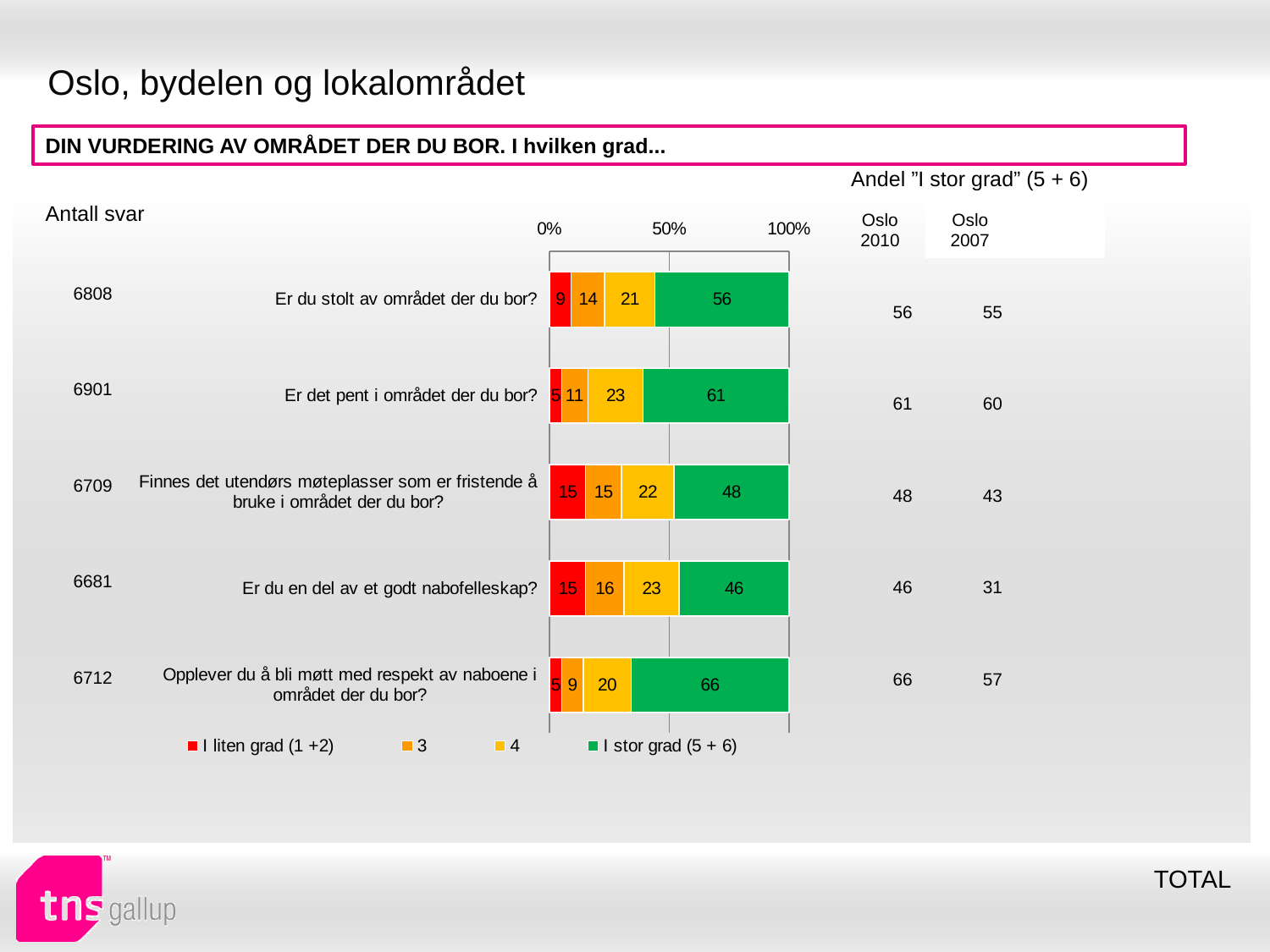
What kind of chart is shown on the slide? Stacked bar chart How many series does the legend list? 4 What is the value of "4" for "Er det pent i området der du bor?"? 23 What is the value of "3" for "Opplever du å bli møtt med respekt av naboene i området der du bor?"? 9 What is the value of "I liten grad (1 +2)" for "Er du en del av et godt nabofelleskap?"? 15 What is the total of the stacked bar for "Finnes det utendørs møteplasser som er fristende å bruke i området der du bor?"? 100 How many categories (questions) are shown in the chart? 5 What is the difference between the "I stor grad (5 + 6)" values for "Er det pent i området der du bor?" and "Finnes det utendørs møteplasser som er fristende å bruke i området der du bor?"? 13 Which category has the highest value for "I stor grad (5 + 6)"? Opplever du å bli møtt med respekt av naboene i området der du bor? Which is larger: the "I liten grad (1 +2)" value for "Er du stolt av området der du bor?" or for "Er det pent i området der du bor?"? Er du stolt av området der du bor? Which category has the lowest value for "I stor grad (5 + 6)"? Er du en del av et godt nabofelleskap? What is the value of "I stor grad (5 + 6)" for "Er du stolt av området der du bor?"? 56